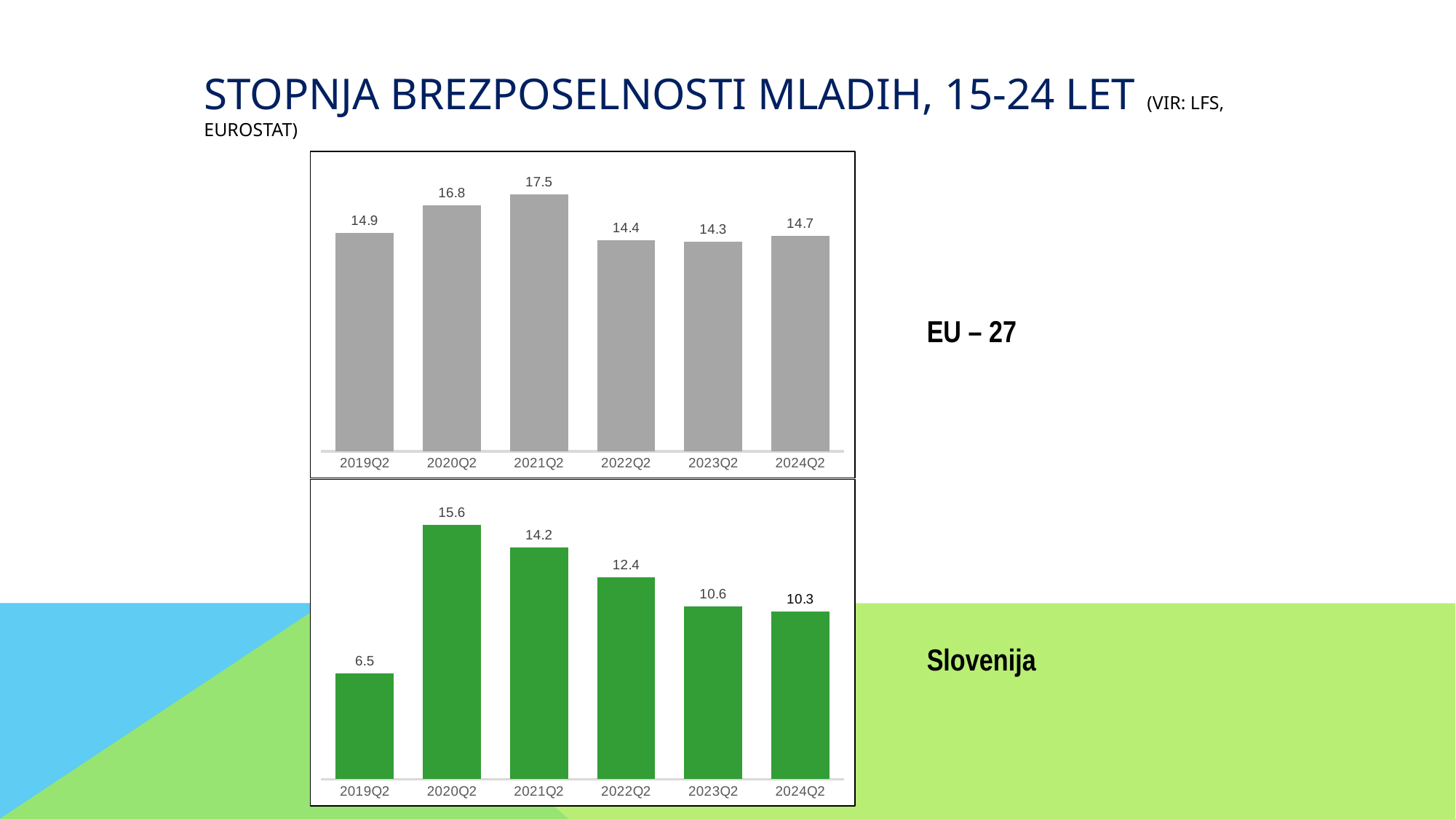
In the bottom chart (Slovenija), which is larger, the value for 2022Q2 or the value for 2023Q2? 2022Q2 In the bottom chart (Slovenija), do the values rise or fall from 2020Q2 to 2024Q2? Fall In the top chart (EU – 27), what is the value for 2021Q2? 17.5 In the bottom chart (Slovenija), what is the value for 2019Q2? 6.5 In the top chart (EU – 27), which period has the highest value? 2021Q2 How many periods are shown on the x axis of the top chart (EU – 27)? 6 In the bottom chart (Slovenija), which period has the lowest value? 2019Q2 What kind of chart is the bottom chart (Slovenija)? Bar chart In the bottom chart (Slovenija), what is the difference between the values for 2020Q2 and 2024Q2? 5.3 What colour are the bars in the bottom chart (Slovenija)? Green In the bottom chart (Slovenija), which period has the highest value? 2020Q2 In the top chart (EU – 27), what is the difference between the values for 2021Q2 and 2023Q2? 3.2